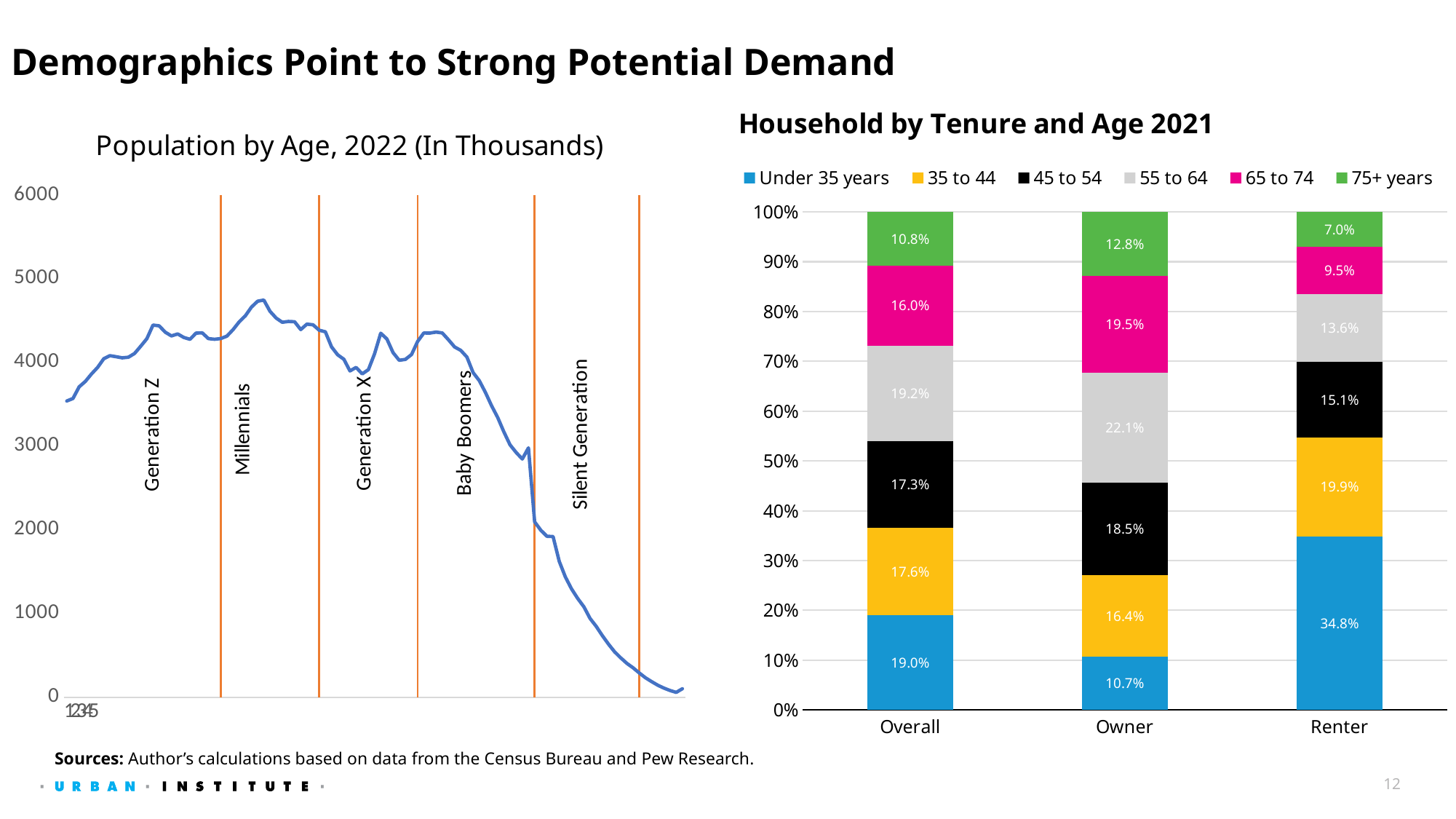
In the Household by Tenure and Age 2021 chart, what share of Renter households are Under 35 years? 34.8% In the Household by Tenure and Age 2021 chart, which tenure category has the largest Under 35 years share? Renter In the Household by Tenure and Age 2021 chart, which is larger: the 65 to 74 share for Owner or for Renter? Owner How many series does the legend of the Household by Tenure and Age 2021 chart list? 6 In the Population by Age, 2022 (In Thousands) chart, does the line rise or fall across the Silent Generation section? Falls How many tenure categories are shown on the x axis of the Household by Tenure and Age 2021 chart? 3 In the Household by Tenure and Age 2021 chart, what share of Overall households are 75+ years? 10.8% In the Household by Tenure and Age 2021 chart, how much larger is the Under 35 years share for Renter than for Owner? 24.1 percentage points What kind of chart is the Population by Age, 2022 (In Thousands) chart? Line chart What kind of chart is the Household by Tenure and Age 2021 chart? Stacked bar chart In the Household by Tenure and Age 2021 chart, which age group has the smallest share among Renter households? 75+ years In the Household by Tenure and Age 2021 chart, what share of Owner households are 55 to 64? 22.1%